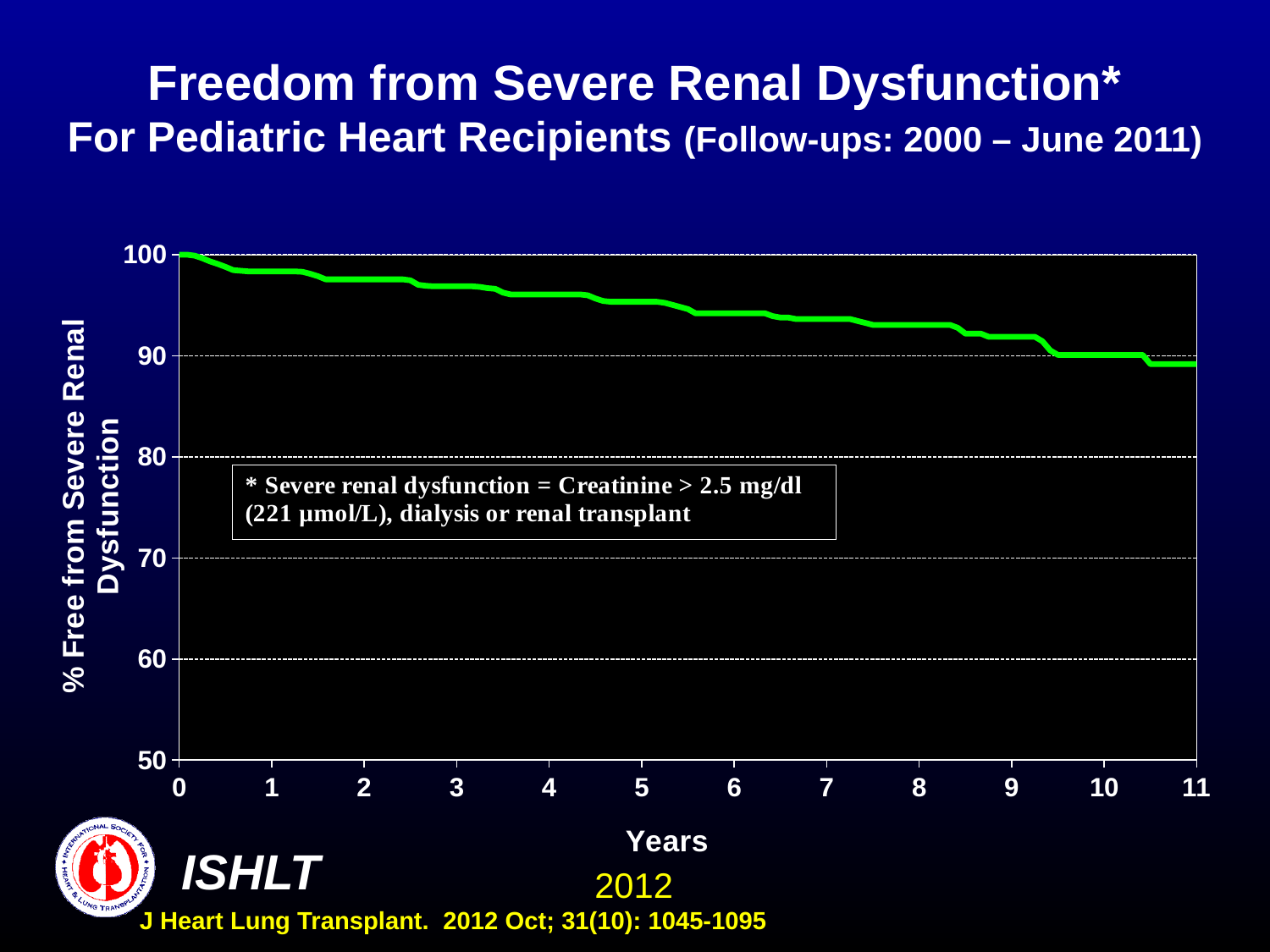
What is the lowest value shown on the y axis? 50 Is the value of the curve at year 8 greater or less than 90? greater Do the values on the chart rise or fall as the years increase along the x axis? fall What is the value of the curve at year 0? 100 What kind of chart is shown on the slide? line chart Is the value of the curve at year 11 greater or less than 90? less Is the value of the curve at year 3 greater or less than 80? greater What is the label of the x axis? Years Which year has the higher value on the curve, year 2 or year 9? year 2